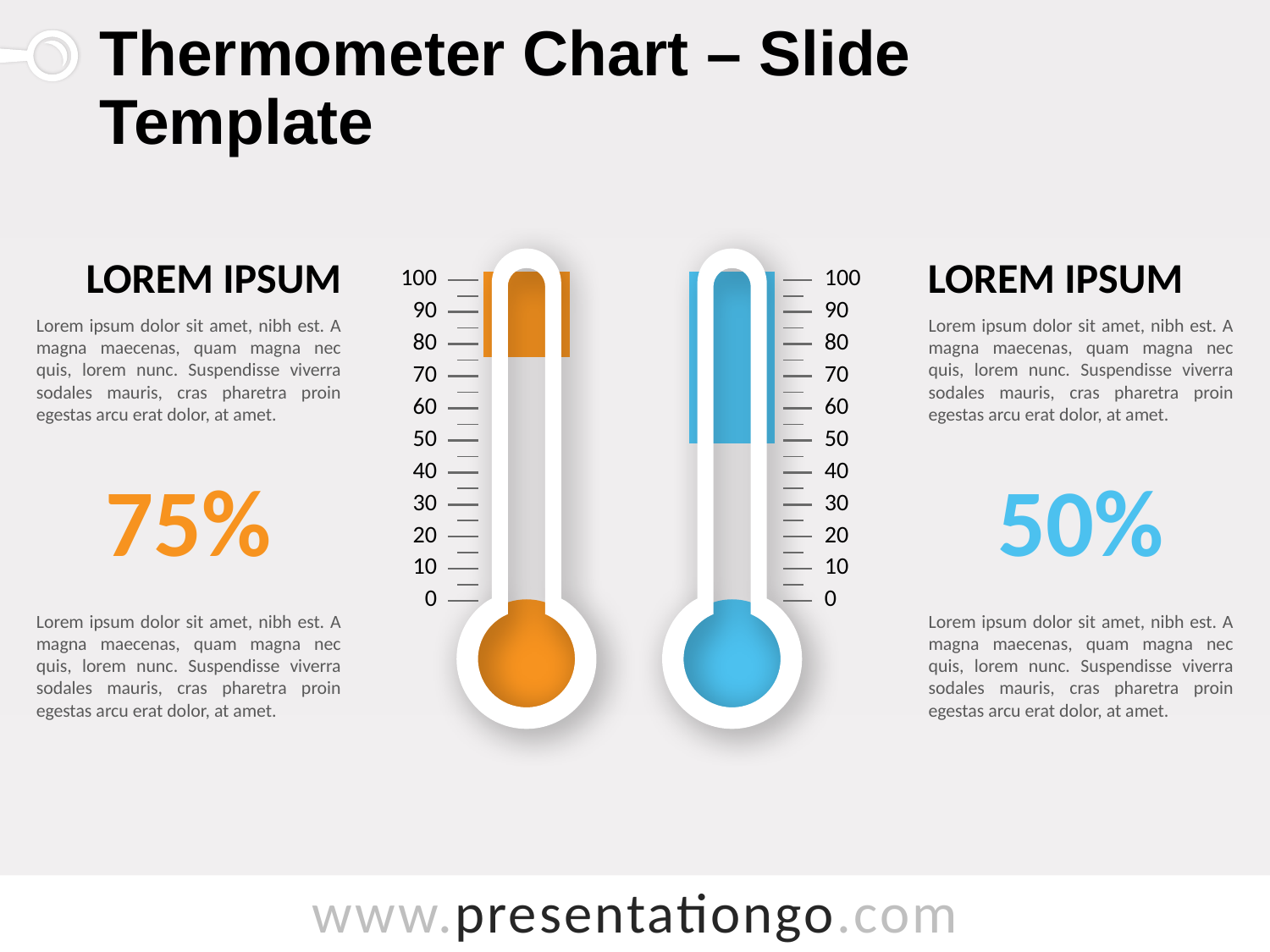
What is the interval between the labelled tick marks on the thermometer scales? 10 What percentage is shown for the orange thermometer on the left? 75% What colour is the thermometer associated with the 50% value? Blue What kind of chart is shown on the slide? Thermometer chart What is the lowest value marked on the thermometer scales? 0 What is the highest value marked on the thermometer scales? 100 Which thermometer shows the lowest percentage? The blue thermometer (50%) What percentage is shown for the blue thermometer on the right? 50% Which thermometer shows the higher percentage, the orange one or the blue one? The orange one (75%) How many thermometer charts are shown on the slide? 2 What is the difference between the percentages shown for the orange and blue thermometers? 25 percentage points How many labelled tick values are there on each thermometer scale? 11